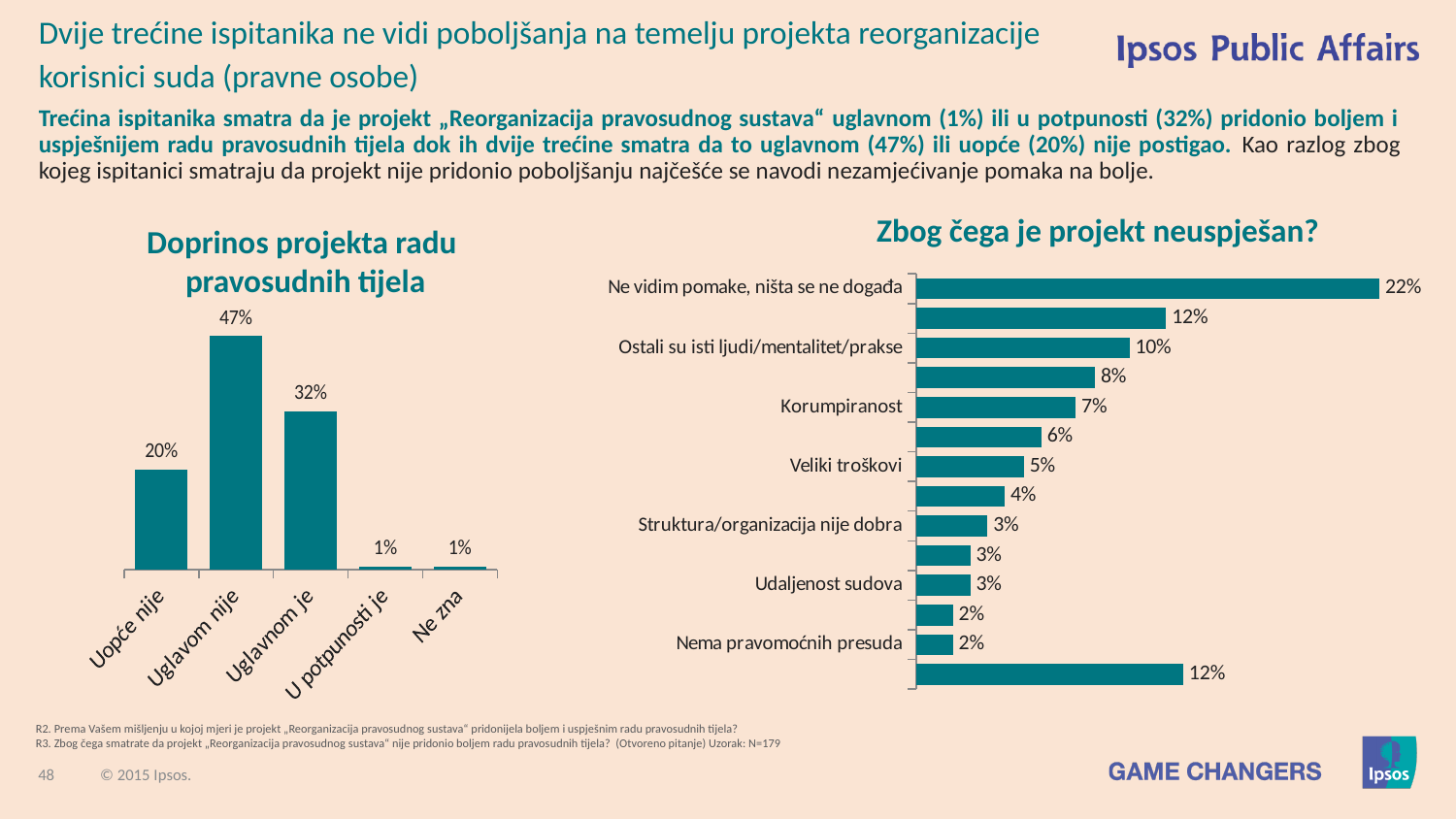
What type of chart is 'Zbog čega je projekt neuspješan?'? Bar chart In the chart 'Doprinos projekta radu pravosudnih tijela', what is the value for 'Uopće nije'? 20% In the chart 'Zbog čega je projekt neuspješan?', which category has the highest value? Ne vidim pomake, ništa se ne događa In the chart 'Doprinos projekta radu pravosudnih tijela', what is the value for 'Uglavnom nije'? 47% In the chart 'Doprinos projekta radu pravosudnih tijela', what is the value for 'Ne zna'? 1% In the chart 'Zbog čega je projekt neuspješan?', which is larger: 'Ostali su isti ljudi/mentalitet/prakse' or 'Veliki troškovi'? Ostali su isti ljudi/mentalitet/prakse In the chart 'Zbog čega je projekt neuspješan?', what is the value for 'Ne vidim pomake, ništa se ne događa'? 22% In the chart 'Zbog čega je projekt neuspješan?', what is the difference between 'Ne vidim pomake, ništa se ne događa' and 'Udaljenost sudova'? 19% In the chart 'Zbog čega je projekt neuspješan?', what is the value for 'Korumpiranost'? 7% In the chart 'Doprinos projekta radu pravosudnih tijela', which category has the highest value? Uglavom nije In the chart 'Doprinos projekta radu pravosudnih tijela', what is the difference between 'Uglavnom nije' and 'Uglavnom je'? 15% In the chart 'Doprinos projekta radu pravosudnih tijela', how many categories are shown? 5